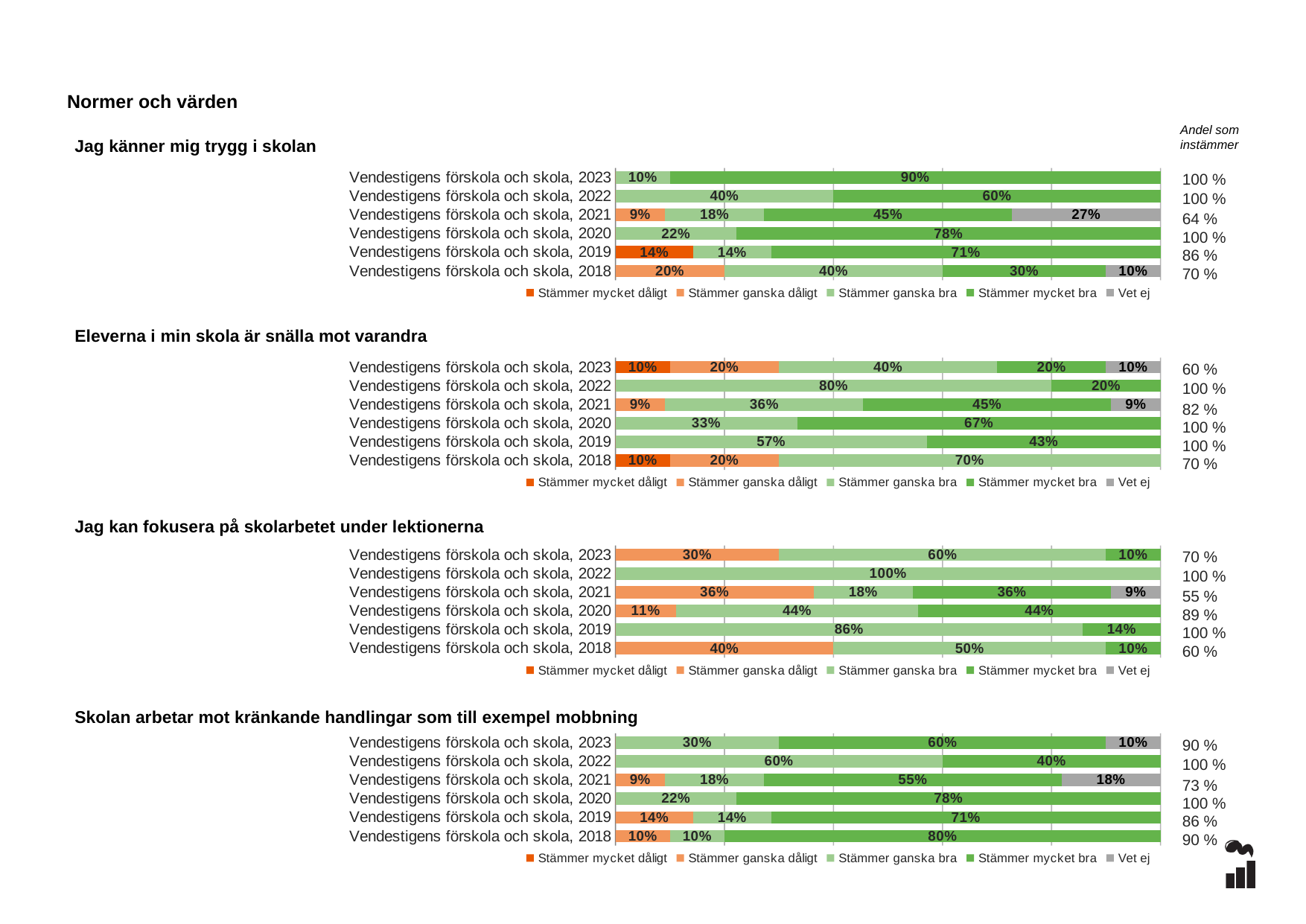
In the chart 'Skolan arbetar mot kränkande handlingar som till exempel mobbning', what is the 'Stämmer mycket bra' value for Vendestigens förskola och skola, 2018? 80% In the chart 'Jag känner mig trygg i skolan', what is the 'Vet ej' value for Vendestigens förskola och skola, 2021? 27% How many bars (years) are shown in the chart 'Jag känner mig trygg i skolan'? 6 In the chart 'Eleverna i min skola är snälla mot varandra', what is the 'Stämmer ganska bra' value for Vendestigens förskola och skola, 2022? 80% In the chart 'Jag kan fokusera på skolarbetet under lektionerna', which year has the lowest 'Andel som instämmer'? 2021 In the chart 'Jag känner mig trygg i skolan', which year has the lowest 'Andel som instämmer'? 2021 In the chart 'Eleverna i min skola är snälla mot varandra', what is the difference between the 'Stämmer mycket bra' values for 2020 and 2019? 24% In the chart 'Eleverna i min skola är snälla mot varandra', what is the 'Andel som instämmer' for Vendestigens förskola och skola, 2023? 60 % In the chart 'Jag kan fokusera på skolarbetet under lektionerna', is the 'Stämmer ganska bra' value larger for 2019 or 2020? 2019 In the chart 'Jag kan fokusera på skolarbetet under lektionerna', what is the 'Stämmer ganska dåligt' value for Vendestigens förskola och skola, 2018? 40% In the chart 'Jag känner mig trygg i skolan', what is the 'Stämmer mycket bra' value for Vendestigens förskola och skola, 2023? 90% How many series does the legend list in the chart 'Skolan arbetar mot kränkande handlingar som till exempel mobbning'? 5